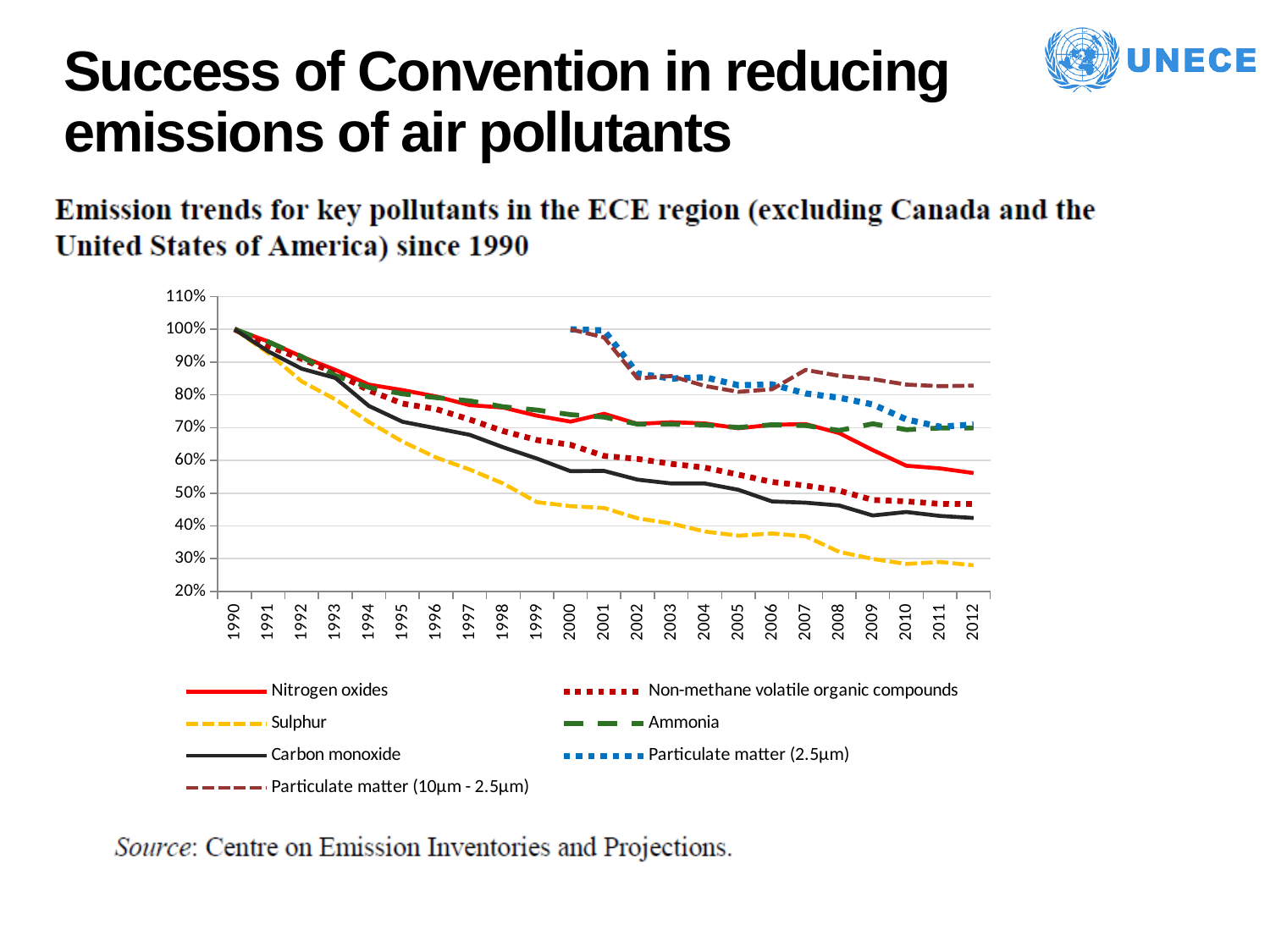
In which year do the Particulate matter series first appear on the chart? 2000 Is the value for Sulphur in 2012 greater or less than 40%? less What kind of chart is shown on the slide? line chart Which series has the lowest value in 2012? Sulphur What is the value for Nitrogen oxides in 1990? 100% Is the value for Carbon monoxide in 2012 greater or less than 50%? less How many series does the legend list? 7 In 2012, which is larger: the value for Carbon monoxide or the value for Sulphur? Carbon monoxide Is the value for Particulate matter (10µm - 2.5µm) in 2012 greater or less than 80%? greater Which series has the highest value in 2012? Particulate matter (10µm - 2.5µm) How many years are shown along the x axis? 23 Do the Sulphur values rise or fall from 1990 to 2012? fall